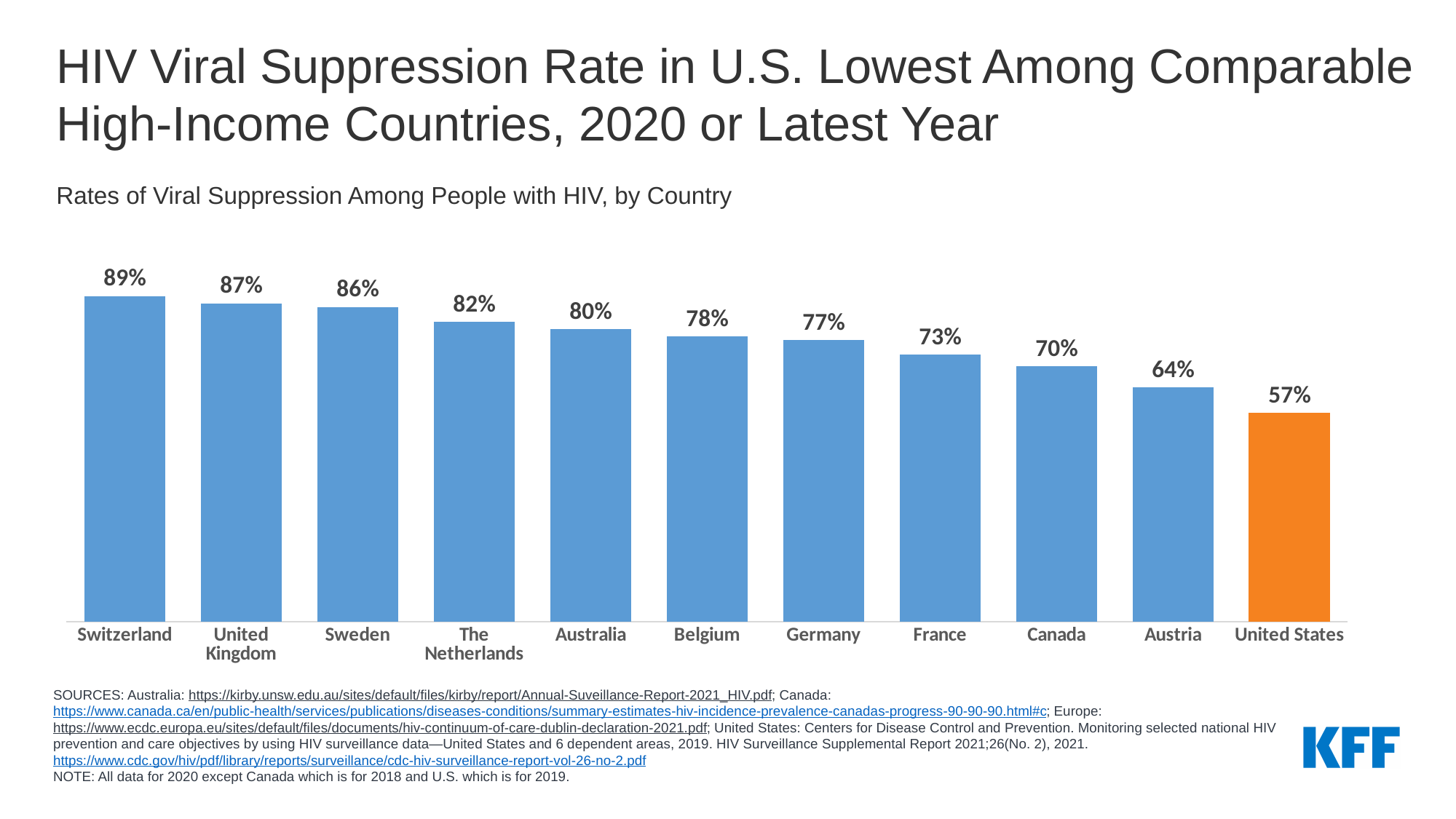
Do the values rise or fall from left to right across the chart? Fall What is the difference in viral suppression rate between Germany and France? 4 percentage points How many countries are shown in the chart? 11 Which country's bar is coloured orange instead of blue? United States What type of chart is shown on the slide? Bar chart Which country has the highest viral suppression rate? Switzerland Which country has the lowest viral suppression rate? United States What is the difference in viral suppression rate between Switzerland and the United States? 32 percentage points What is the viral suppression rate for Canada? 70% Which has a higher viral suppression rate, Australia or Belgium? Australia What is the viral suppression rate for Switzerland? 89% What is the viral suppression rate for the United States? 57%